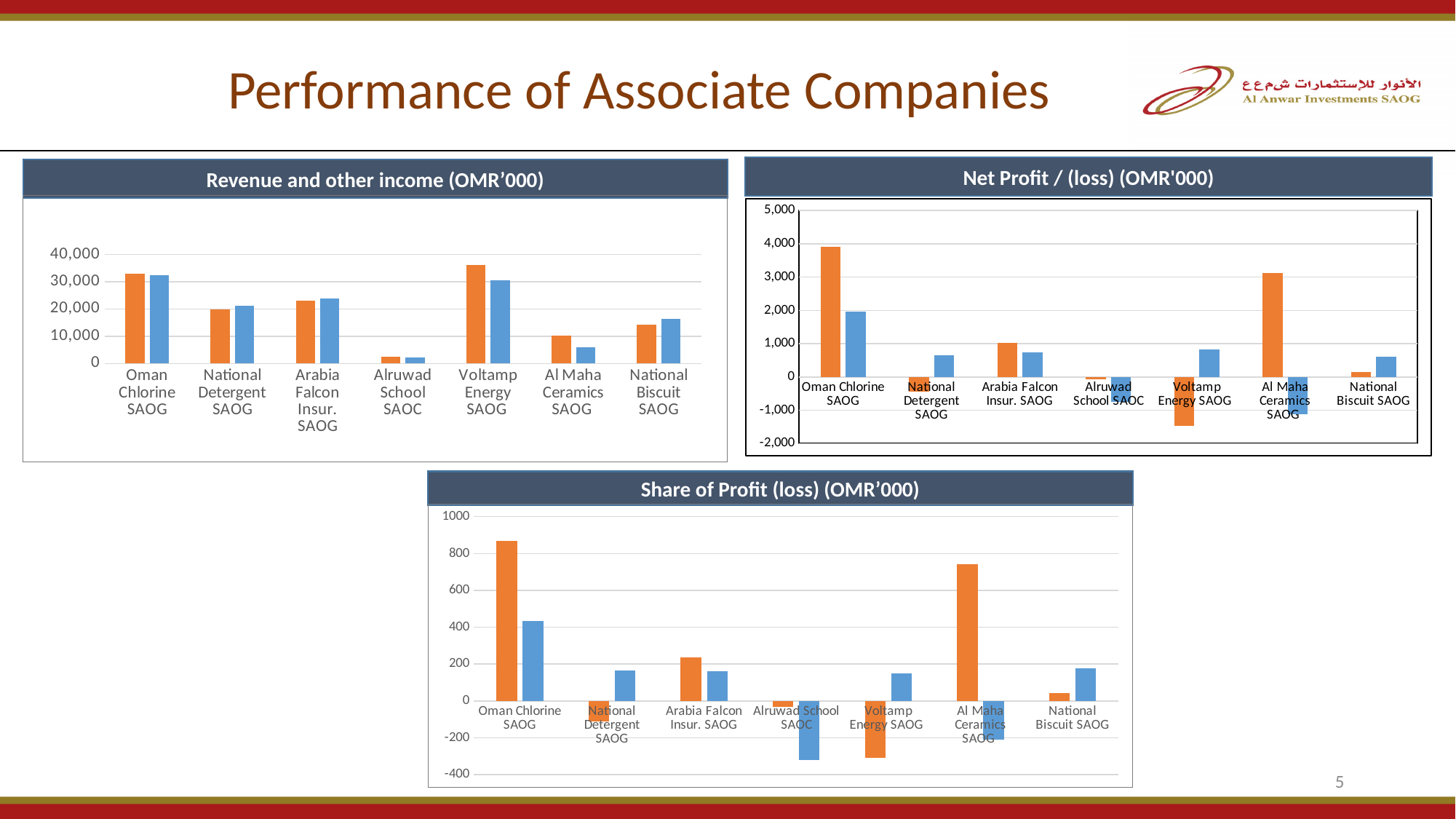
In the 'Revenue and other income (OMR'000)' chart, which company has the lowest bars? Alruwad School SAOC In the 'Share of Profit (loss) (OMR'000)' chart, is the orange bar for Oman Chlorine SAOG greater or less than 800? greater In the 'Net Profit / (loss) (OMR'000)' chart, which company has the highest orange bar? Oman Chlorine SAOG In the 'Share of Profit (loss) (OMR'000)' chart, which company has the lowest blue bar? Alruwad School SAOC In the 'Share of Profit (loss) (OMR'000)' chart, which is larger for Oman Chlorine SAOG, the orange bar or the blue bar? the orange bar In the 'Net Profit / (loss) (OMR'000)' chart, which company has the lowest orange bar? Voltamp Energy SAOG How many companies are shown on the x axis of the 'Net Profit / (loss) (OMR'000)' chart? 7 What kind of chart is the 'Revenue and other income (OMR'000)' chart? bar chart In the 'Revenue and other income (OMR'000)' chart, which company has the tallest orange bar? Voltamp Energy SAOG In the 'Revenue and other income (OMR'000)' chart, is the blue bar for National Biscuit SAOG greater or less than 20,000? less In the 'Revenue and other income (OMR'000)' chart, is the orange bar for Oman Chlorine SAOG greater or less than 30,000? greater